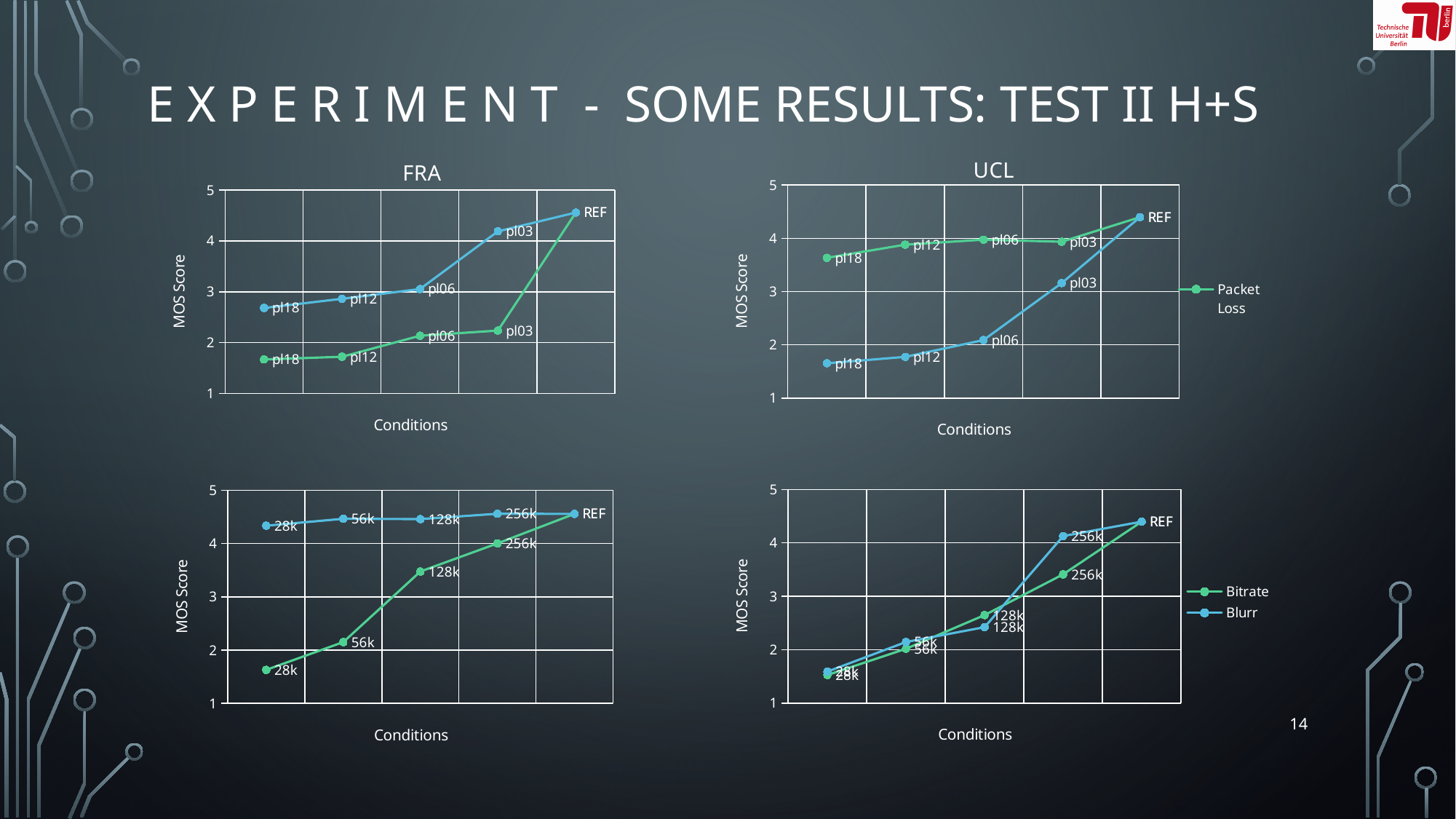
In the UCL chart, is the green line's value for pl18 greater or less than 3? greater In the bottom-left chart, is the green line's value for 56k greater or less than 3? less In the FRA chart, how many labelled conditions does each line pass through? 5 In the UCL chart, is the blue line's value for pl06 greater or less than 3? less How many series does the legend of the bottom-right chart list? 2 In the FRA chart, do the MOS scores rise or fall from pl18 to REF? rise In the bottom-right chart, at 256k, which series has the higher MOS score, Bitrate or Blurr? Blurr In the UCL chart, at pl12, which line has the higher MOS score, the green or the blue? green What kind of chart is the FRA chart? line chart